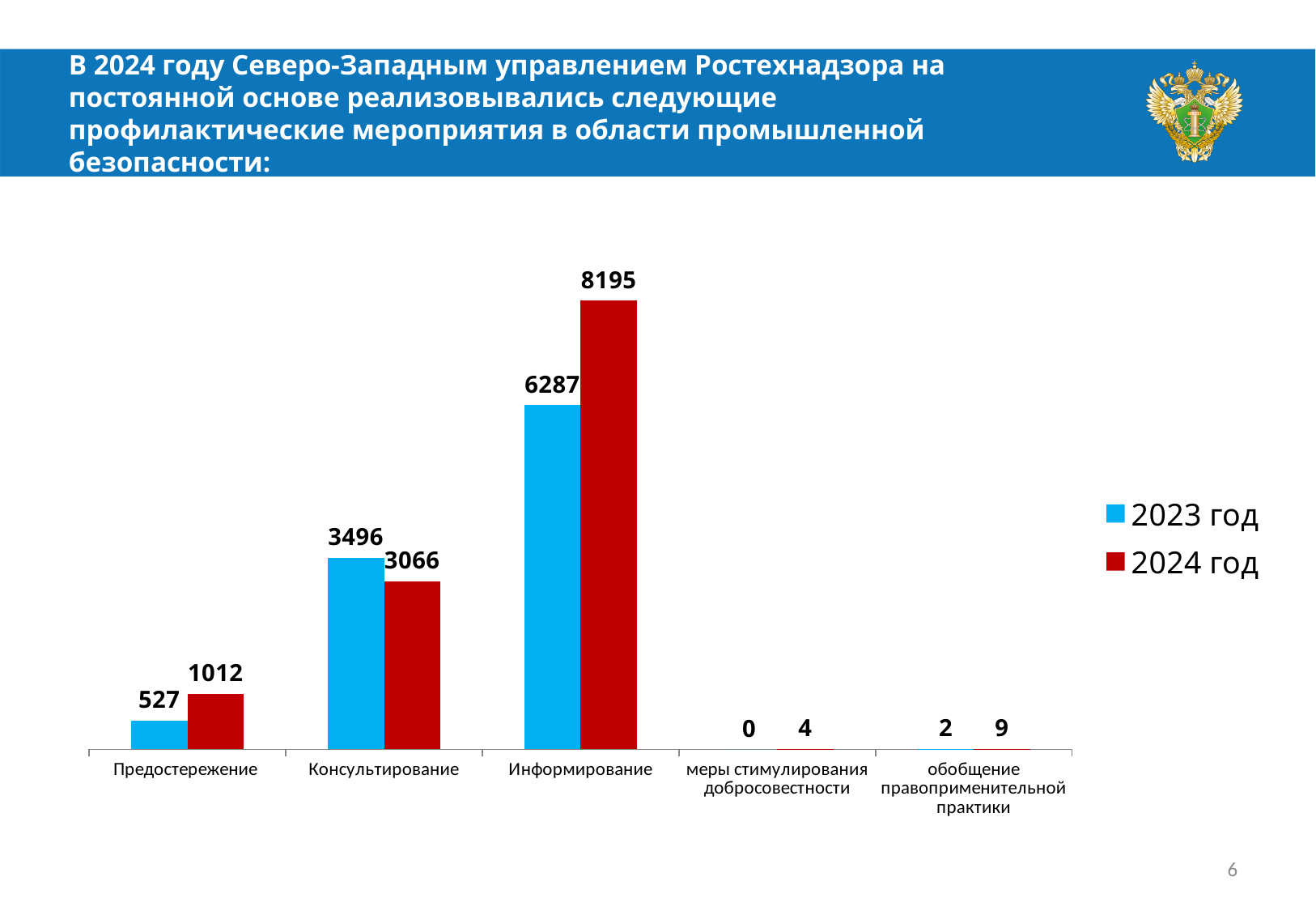
What is the difference between the 2024 год and 2023 год values for Информирование? 1908 Which category has the lowest value in the 2023 год series? меры стимулирования добросовестности How many categories are shown on the x axis? 5 Which is larger for Предостережение: the 2023 год value or the 2024 год value? 2024 год What is the value for Предостережение in the 2023 год series? 527 What is the value for Информирование in the 2024 год series? 8195 What is the difference between the 2023 год and 2024 год values for Консультирование? 430 What is the value for Консультирование in the 2024 год series? 3066 How many series does the legend list? 2 What is the value for меры стимулирования добросовестности in the 2023 год series? 0 Which category has the highest value in the 2024 год series? Информирование What kind of chart is shown on the slide? bar chart